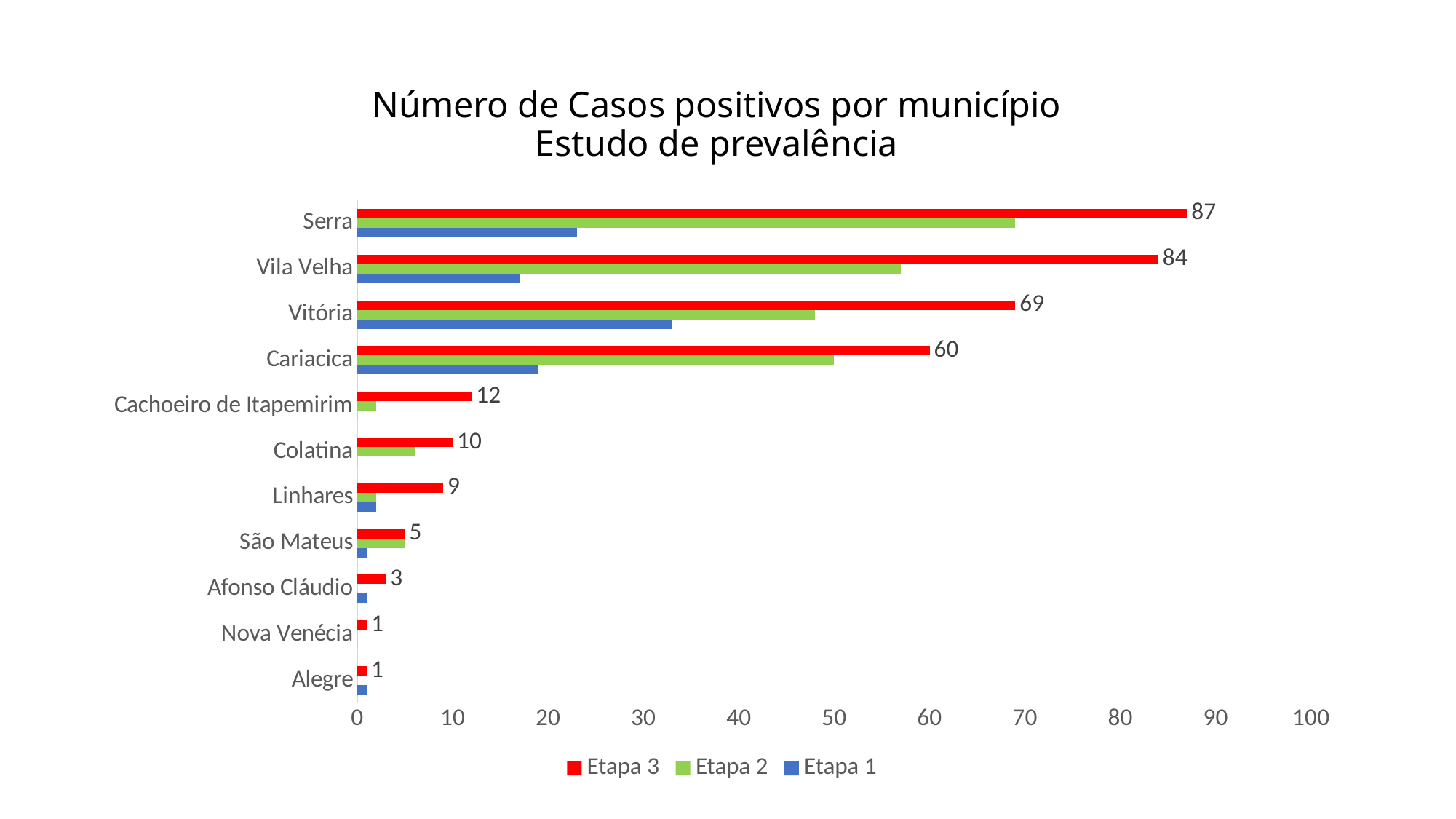
How many municipalities are shown on the chart? 11 What is the title of the chart? Número de Casos positivos por município Estudo de prevalência Which has the larger Etapa 3 value, Vitória or Cariacica? Vitória What is the Etapa 3 value for Cachoeiro de Itapemirim? 12 How many series does the legend list? 3 Is the Etapa 1 value for Vila Velha greater or less than 20? less What type of chart is shown on the slide? bar chart What is the Etapa 3 value for Cariacica? 60 What is the difference between the Etapa 3 values for Serra and Vila Velha? 3 What is the Etapa 3 value for Serra? 87 Which municipality has the highest Etapa 3 value? Serra Is the Etapa 2 value for Serra greater or less than 60? greater